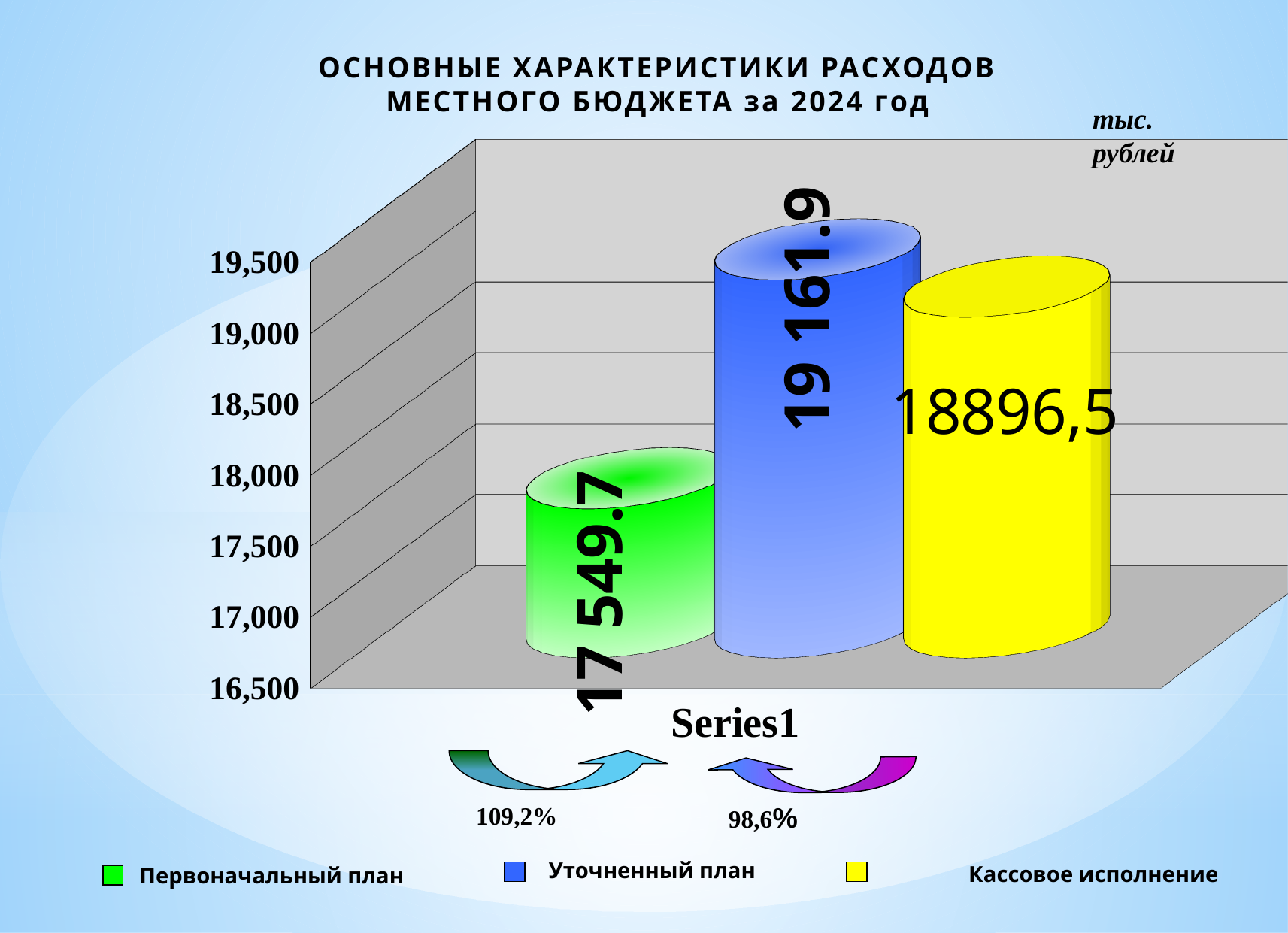
What type of chart is shown on the slide? Bar chart Is the value for Уточненный план greater or less than 19,000? greater Which is larger, Кассовое исполнение or Первоначальный план? Кассовое исполнение What unit of measurement is indicated for the chart values? тыс. рублей What is the value for Уточненный план? 19 161.9 What is the value for Кассовое исполнение? 18896,5 Which series has the highest value? Уточненный план Is the value for Первоначальный план greater or less than 18,000? less Which series has the lowest value? Первоначальный план How many series does the legend list? 3 What colour is the bar for Кассовое исполнение? Yellow What is the value for Первоначальный план? 17 549.7